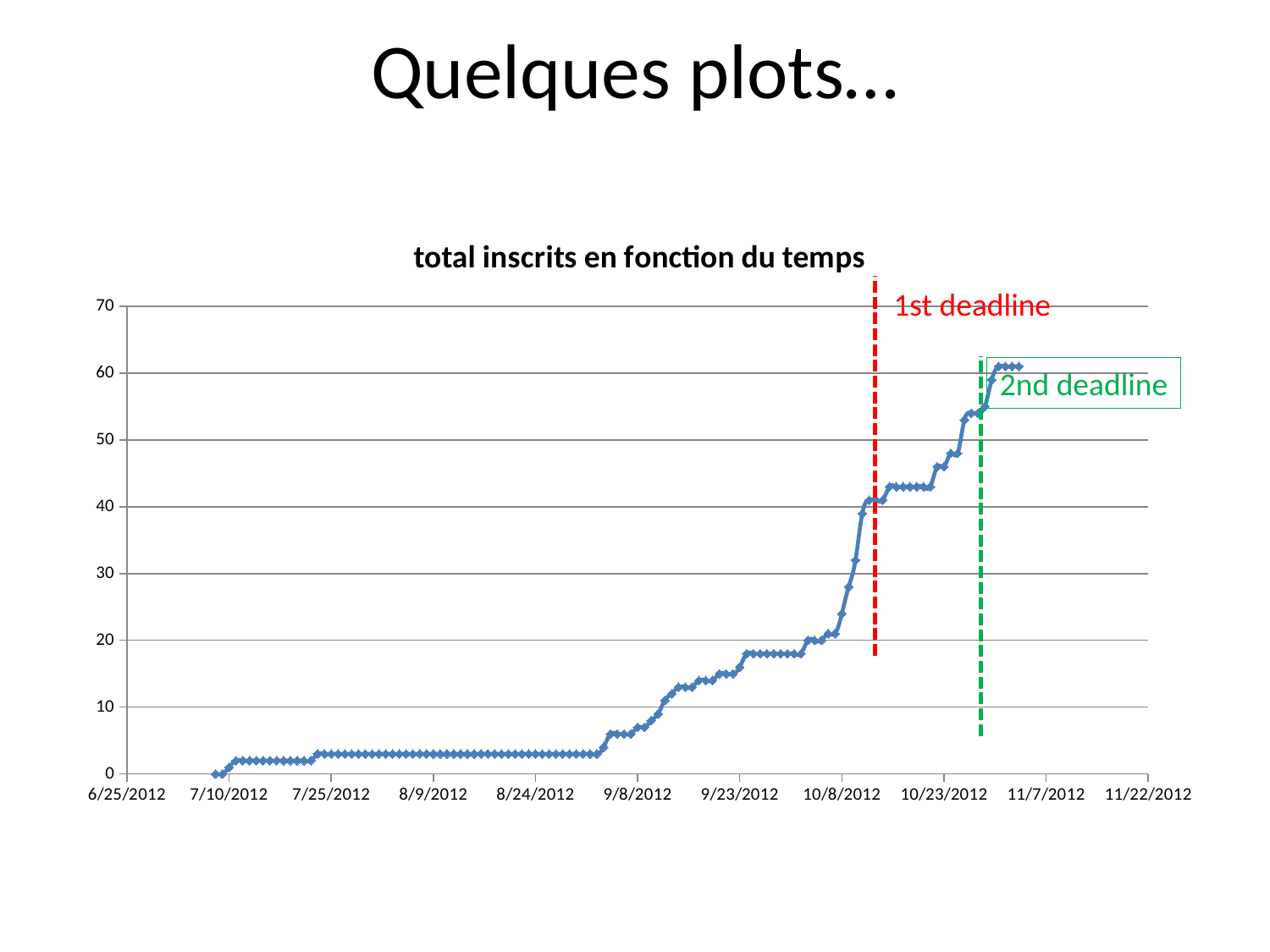
Is the value of the line at 10/23/2012 greater or less than 40? greater What is the title of the chart? total inscrits en fonction du temps What does the red dashed vertical line on the chart mark? 1st deadline Is the value of the line at 9/23/2012 greater or less than 10? greater What kind of chart is shown on the slide? line chart Is the value of the line at 9/23/2012 greater or less than 20? less Do the values rise or fall along the x axis from 7/10/2012 to 11/7/2012? rise